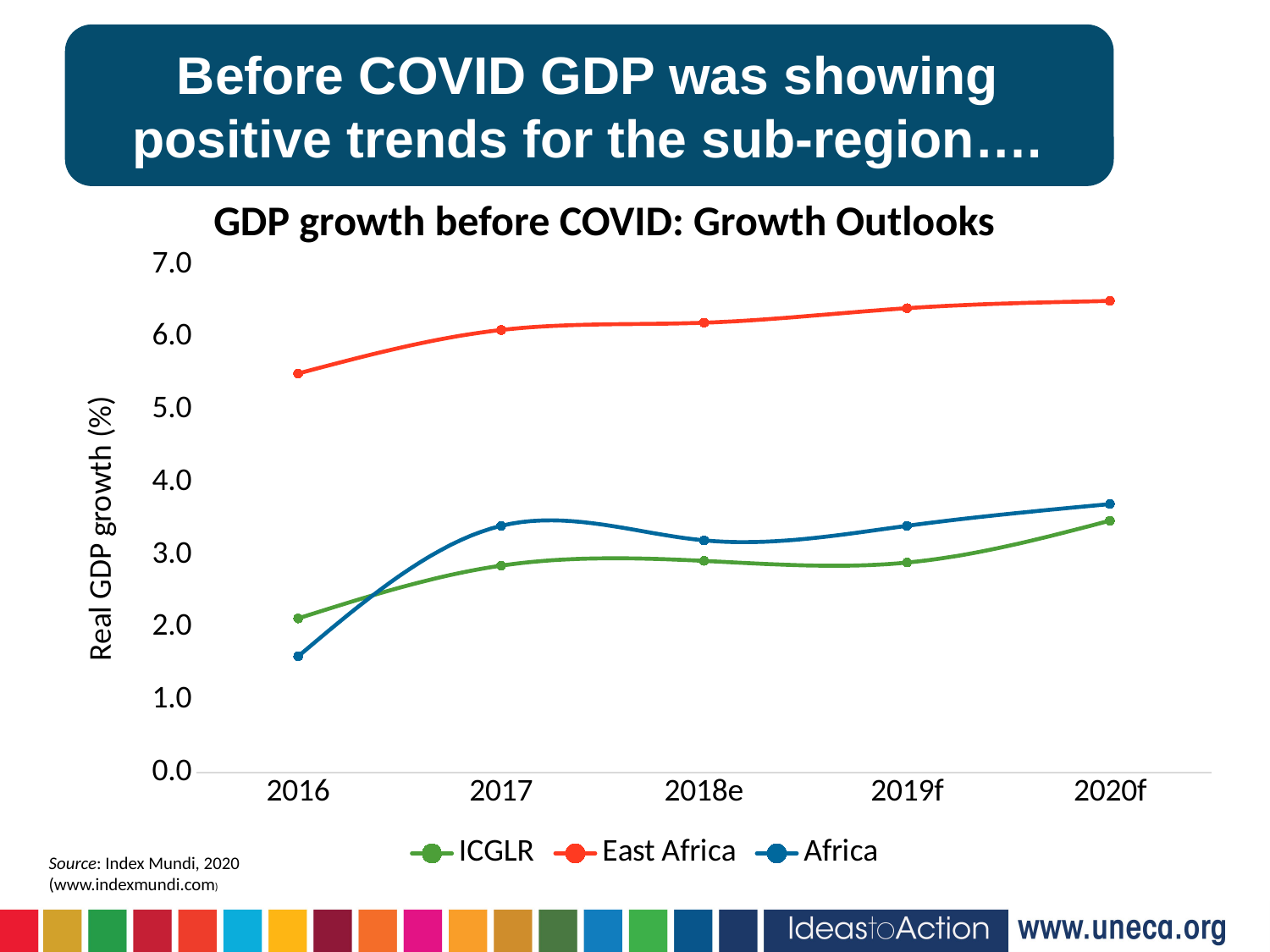
What kind of chart is shown on the slide? line chart Does the East Africa line rise or fall from 2016 to 2020f? rise How many years are shown on the x axis? 5 Is the value for East Africa in 2016 greater or less than 5.0? greater What is the label of the vertical axis? Real GDP growth (%) How many series does the legend list? 3 Which series has the lowest value in 2016? Africa Is the value for Africa in 2016 greater or less than 2.0? less Is the value for East Africa in 2020f greater or less than 6.0? greater What is the title of the chart? GDP growth before COVID: Growth Outlooks In 2017, which is larger: the value for Africa or the value for ICGLR? Africa Which series has the highest value in 2020f? East Africa